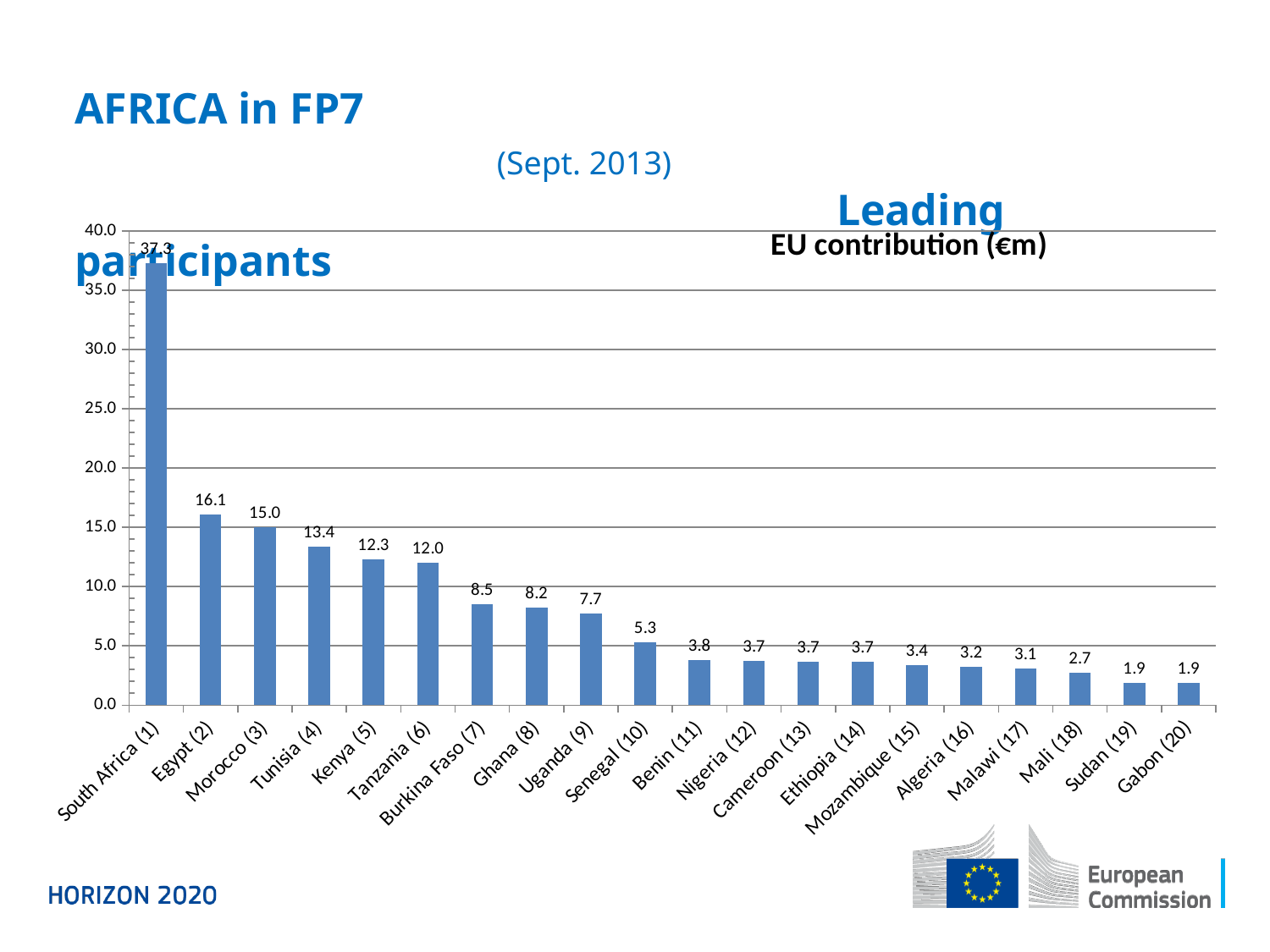
Is the EU contribution for Tanzania (6) greater or less than 10.0? greater Which has a larger EU contribution, Ghana (8) or Uganda (9)? Ghana (8) What is the difference in EU contribution (€m) between South Africa (1) and Egypt (2)? 21.2 Do the values rise or fall from left to right along the x axis? fall Which country has the highest EU contribution? South Africa (1) What is the difference in EU contribution (€m) between Morocco (3) and Tunisia (4)? 1.6 What is the EU contribution (€m) for Kenya (5)? 12.3 What is the EU contribution (€m) for Mali (18)? 2.7 What kind of chart is shown on the slide? bar chart What is the EU contribution (€m) for Egypt (2)? 16.1 What is the EU contribution (€m) for Senegal (10)? 5.3 How many countries are shown on the chart? 20